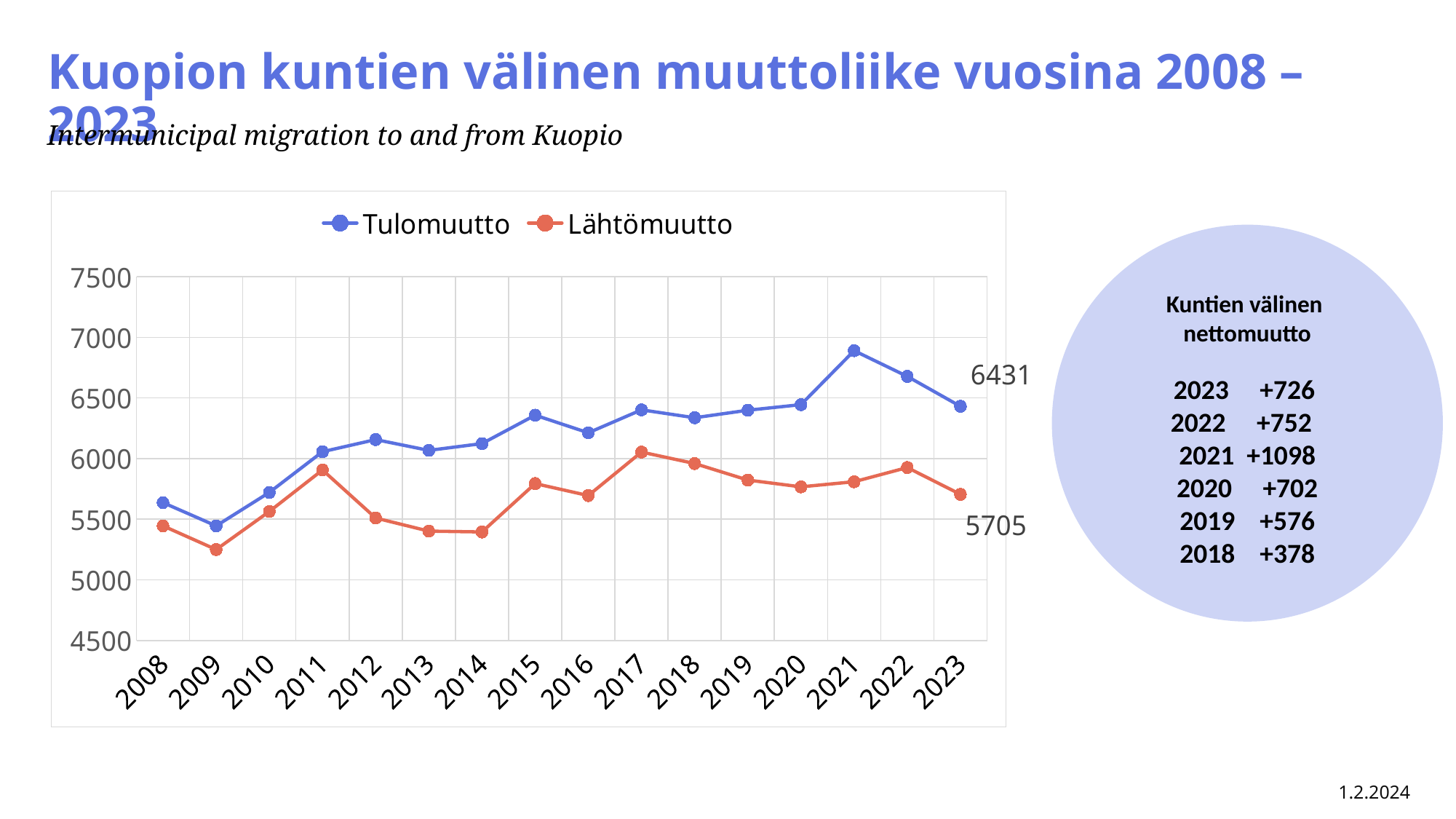
Which is larger in 2023, Tulomuutto or Lähtömuutto? Tulomuutto Is the Tulomuutto value for 2021 greater or less than 6500? greater In which year does the Lähtömuutto series reach its highest value? 2017 How many years are plotted on the x axis? 16 Is the Lähtömuutto value for 2009 greater or less than 5500? less What is the Tulomuutto value for 2023? 6431 What is the difference between the Tulomuutto and Lähtömuutto values in 2023? 726 In which year does the Lähtömuutto series reach its lowest value? 2009 How many series does the legend list? 2 In which year does the Tulomuutto series reach its highest value? 2021 What is the Lähtömuutto value for 2023? 5705 What kind of chart is shown on the slide? line chart